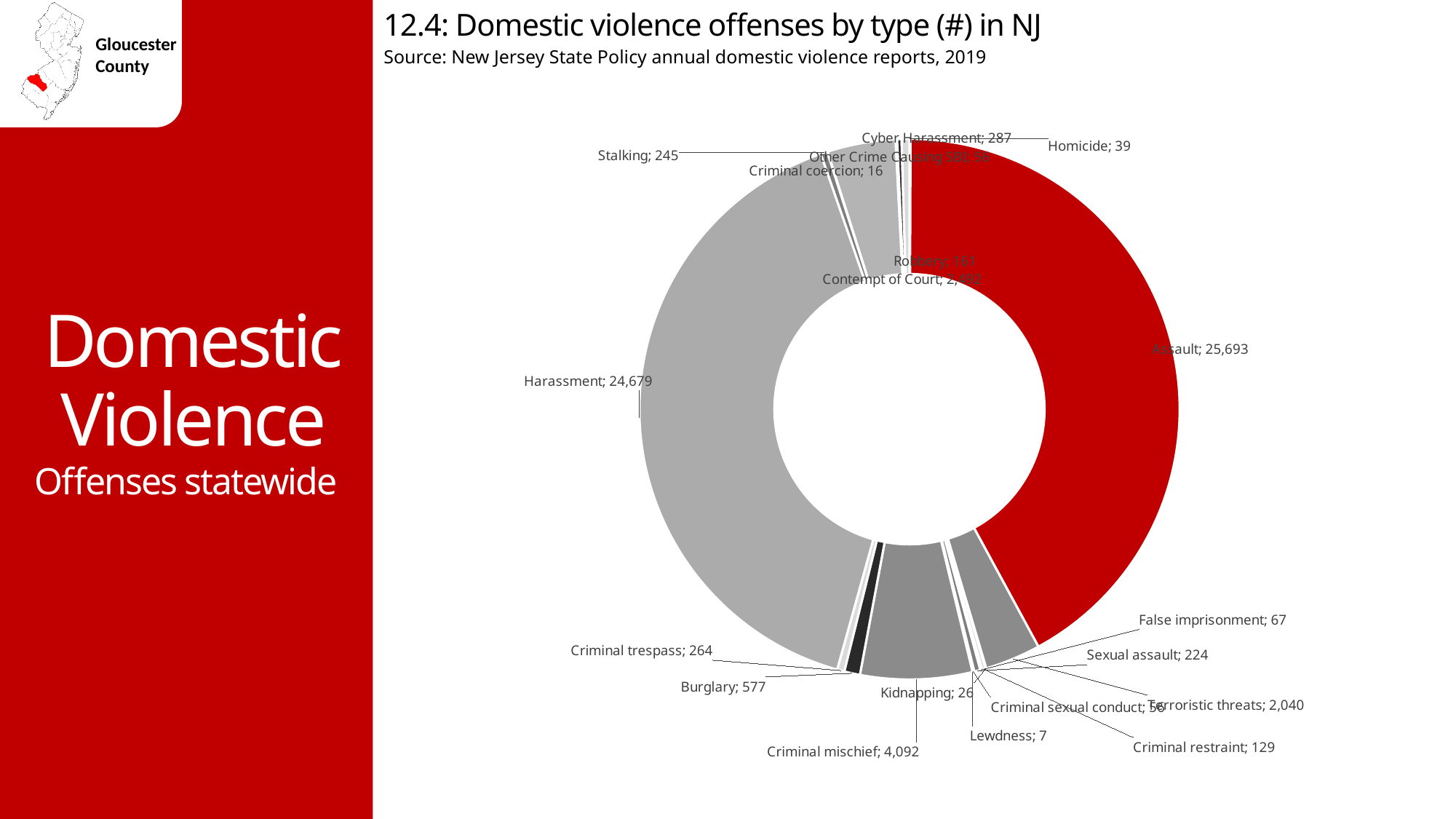
What colour is the Assault segment of the chart? red What kind of chart is shown on the slide? doughnut chart What is the difference between the number of Assault offenses and Harassment offenses? 1,014 How many offenses are shown for Criminal trespass? 264 How many domestic violence offenses are shown for Harassment? 24,679 Which offense type has the highest number of offenses? Assault What is the title of the chart? 12.4: Domestic violence offenses by type (#) in NJ Which has more offenses, Criminal mischief or Terroristic threats? Criminal mischief How many domestic violence offenses are shown for Assault? 25,693 How many offenses are shown for Burglary? 577 Which offense type has the lowest number of offenses? Lewdness How many offenses are shown for Homicide? 39